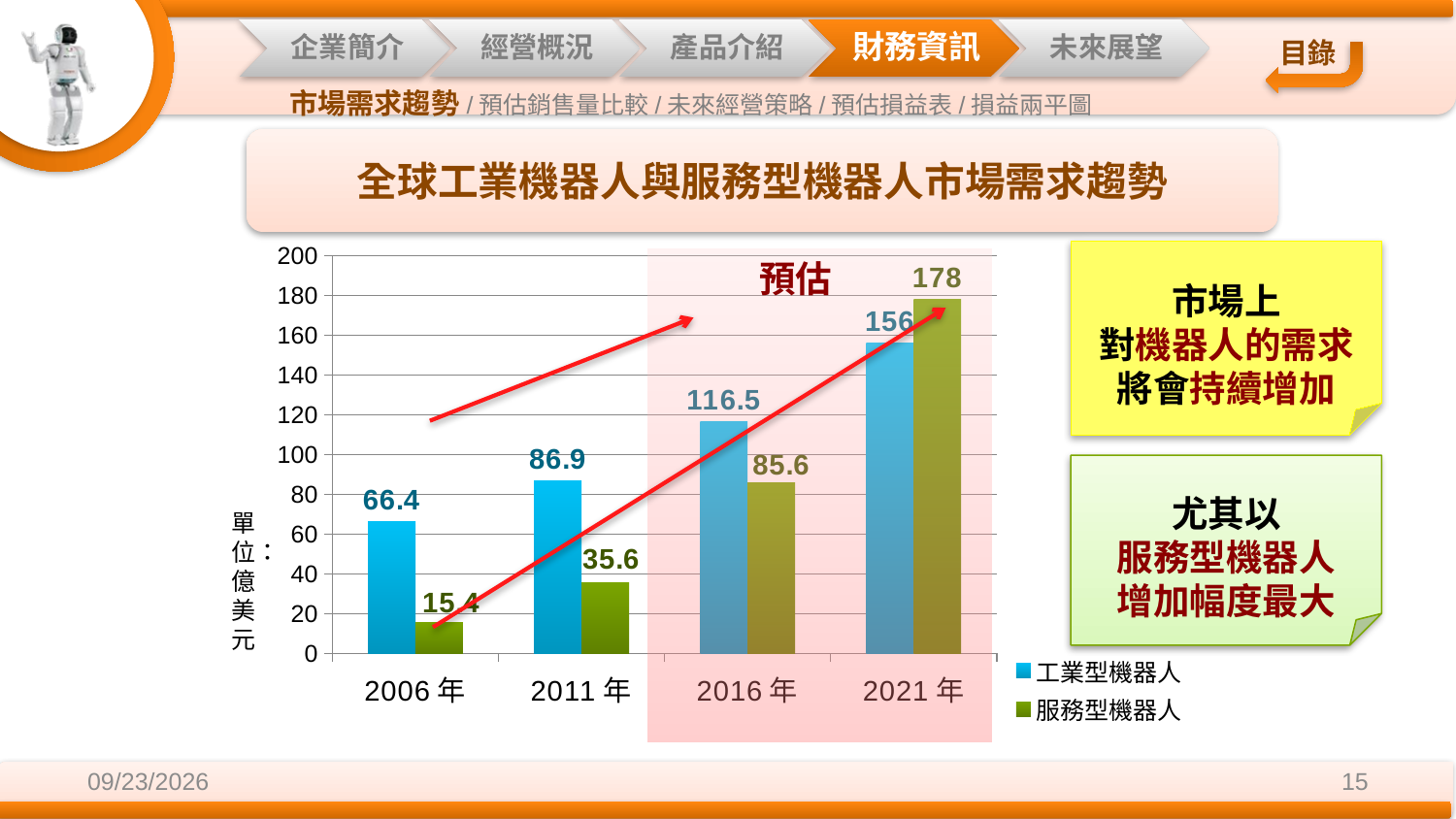
In which year is the value for 服務型機器人 the lowest? 2006 年 Which is larger in 2021 年, 工業型機器人 or 服務型機器人? 服務型機器人 What is the value for 服務型機器人 in 2016 年? 85.6 What is the value for 工業型機器人 in 2011 年? 86.9 What is the difference between 工業型機器人 and 服務型機器人 in 2011 年? 51.3 Do the values for 服務型機器人 rise or fall from 2006 年 to 2021 年? rise What is the value for 服務型機器人 in 2021 年? 178 In which year is the value for 工業型機器人 the highest? 2021 年 What is the value for 工業型機器人 in 2006 年? 66.4 What type of chart is shown on the slide? bar chart How many years are shown on the x axis? 4 How many series does the legend list? 2